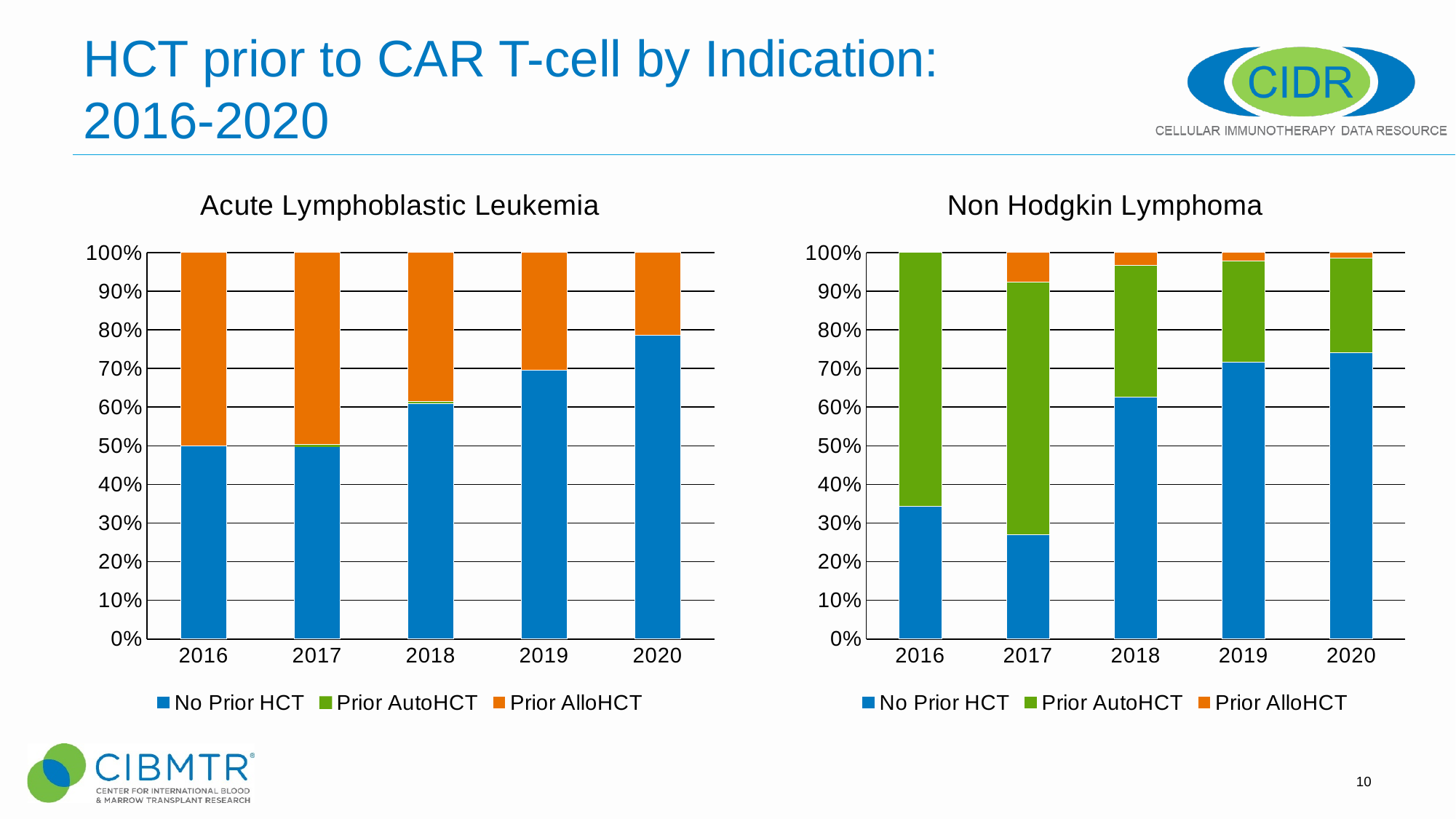
In the Non Hodgkin Lymphoma chart, which year has the highest No Prior HCT share? 2020 In the Non Hodgkin Lymphoma chart, which year has the lowest No Prior HCT share? 2017 What kind of chart is the Acute Lymphoblastic Leukemia chart? Stacked bar chart In the Acute Lymphoblastic Leukemia chart, does the No Prior HCT share rise or fall from 2016 to 2020? Rise In the Non Hodgkin Lymphoma chart, is the Prior AutoHCT value for 2016 greater or less than 60%? greater In the Non Hodgkin Lymphoma chart, is the No Prior HCT share larger in 2018 or in 2019? 2019 In the Non Hodgkin Lymphoma chart, is the No Prior HCT value for 2017 greater or less than 30%? less Which series is shown in green in the legend of the Non Hodgkin Lymphoma chart? Prior AutoHCT In the Acute Lymphoblastic Leukemia chart, is the No Prior HCT value for 2020 greater or less than 70%? greater How many years are shown on the x axis of the Non Hodgkin Lymphoma chart? 5 How many series does the legend of the Acute Lymphoblastic Leukemia chart list? 3